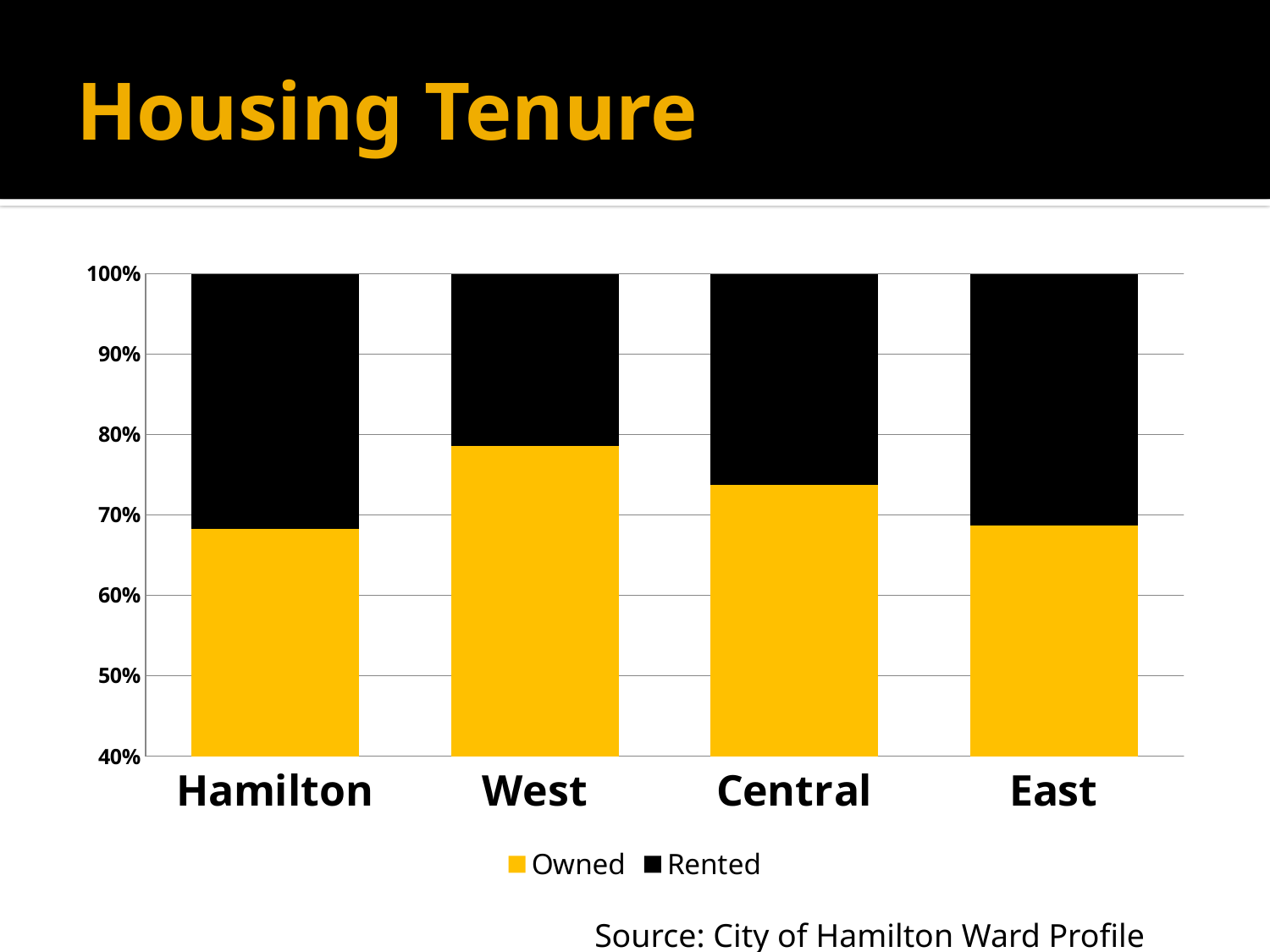
How many series does the legend list? 2 What kind of chart is shown on the slide? Stacked bar chart Is the Owned value for Central greater or less than 70%? greater Is the Owned value for Hamilton greater or less than 70%? less Which category has the smallest Rented share? West What is the title of the slide? Housing Tenure Which has a larger Owned share, Central or Hamilton? Central Is the Owned value for West greater or less than 80%? less Which has a larger Owned share, West or Central? West Which category has the highest Owned share? West How many categories are shown along the x axis? 4